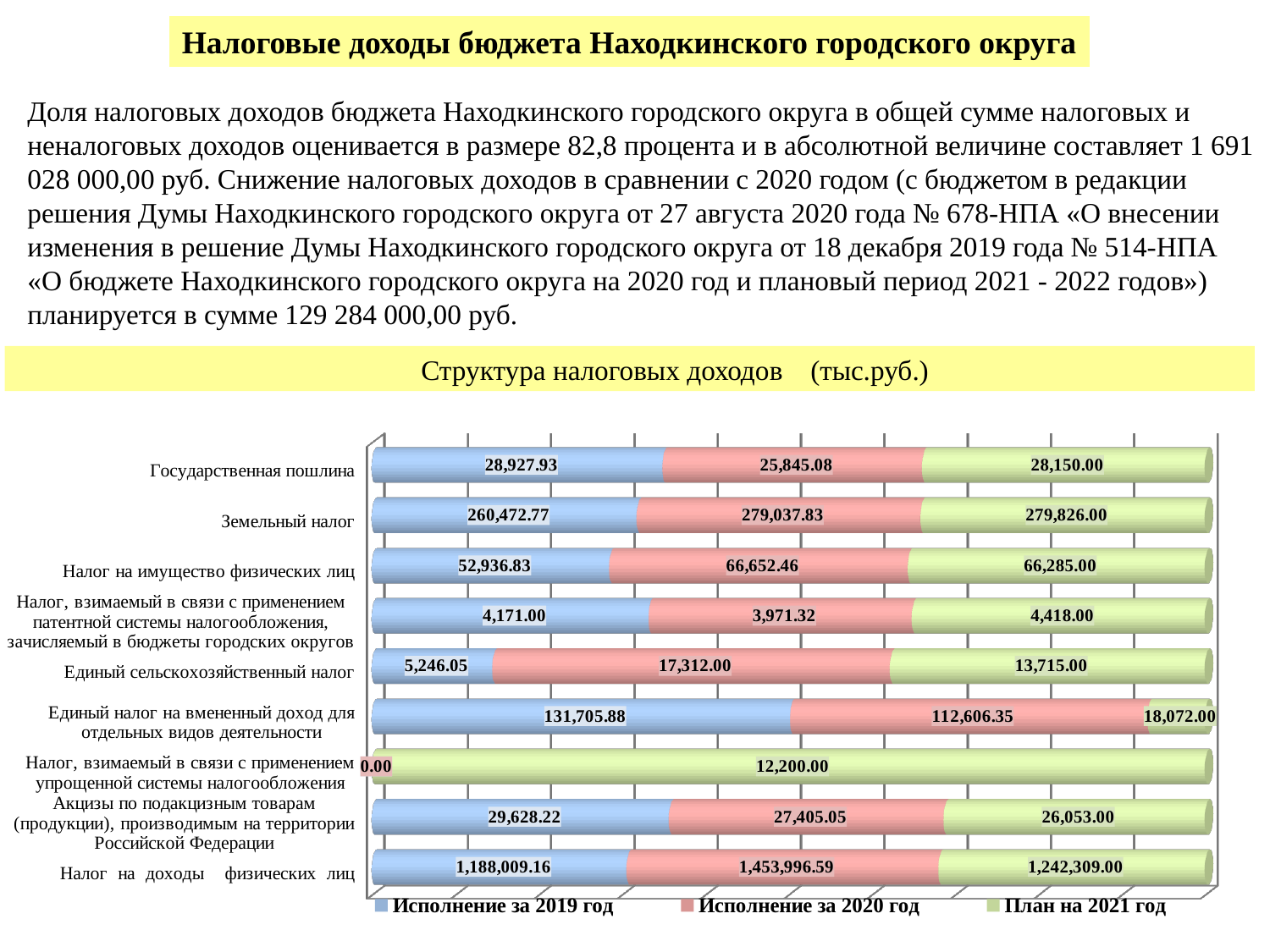
What is the value of 'Исполнение за 2020 год' for 'Единый сельскохозяйственный налог'? 17,312.00 Which category has the highest value for 'Исполнение за 2019 год'? Налог на доходы физических лиц For 'Единый налог на вмененный доход для отдельных видов деятельности', which is larger: 'Исполнение за 2019 год' or 'Исполнение за 2020 год'? Исполнение за 2019 год What is the value of 'Исполнение за 2019 год' for 'Земельный налог'? 260,472.77 How many tax categories are shown on the chart? 9 What is the total of the three values in the bar for 'Государственная пошлина'? 82,923.01 Which category has the lowest value for 'План на 2021 год'? Налог, взимаемый в связи с применением патентной системы налогообложения, зачисляемый в бюджеты городских округов How many series does the legend list? 3 What is the difference between 'Исполнение за 2020 год' and 'Исполнение за 2019 год' for 'Земельный налог'? 18,565.06 What is the value of 'Исполнение за 2020 год' for 'Налог на доходы физических лиц'? 1,453,996.59 What kind of chart is shown on the slide? Stacked bar chart What is the value of 'План на 2021 год' for 'Налог на имущество физических лиц'? 66,285.00